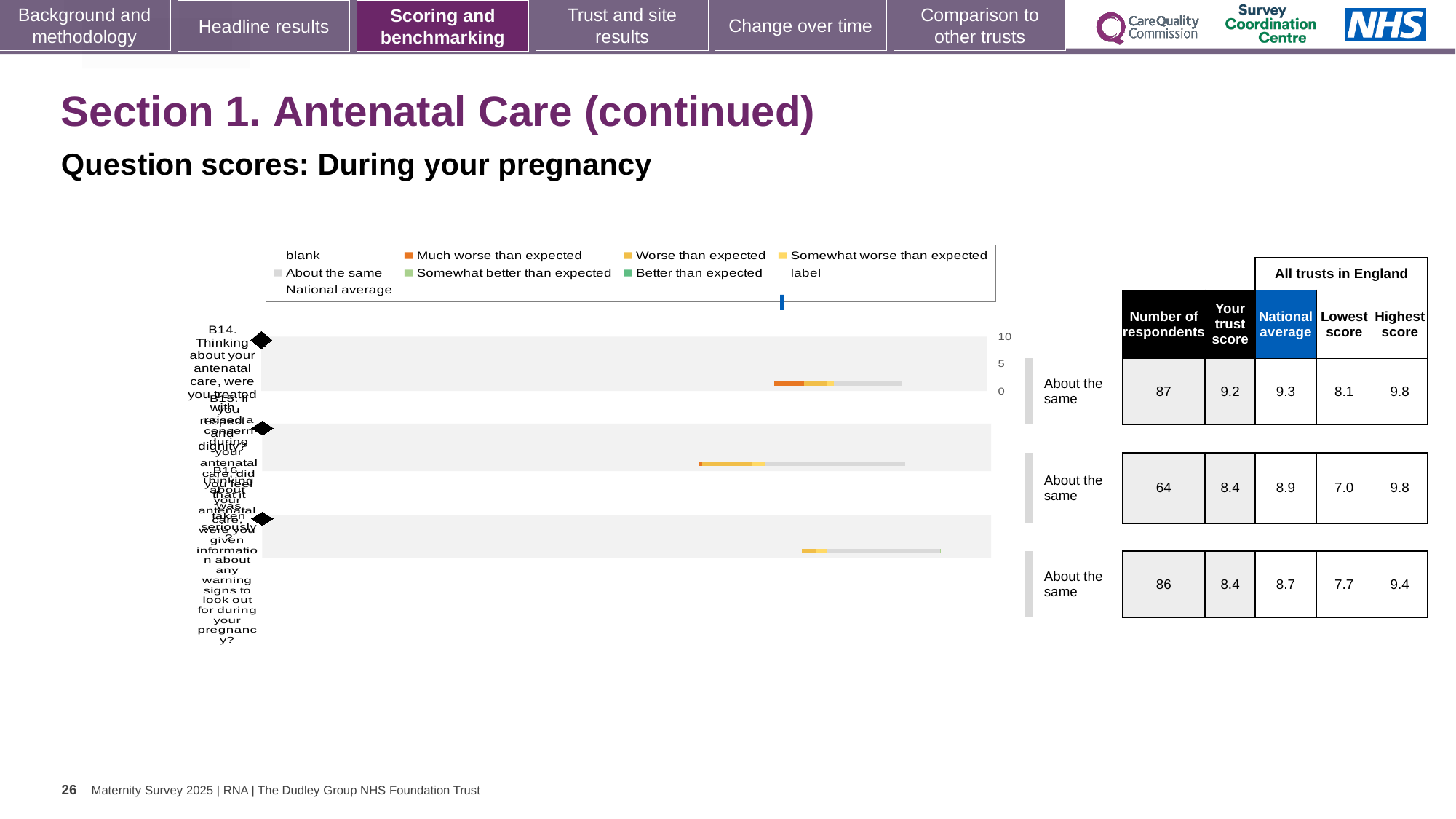
Which question row has the fewest respondents? the second row (64) Which question row has the highest 'Your trust score'? B14 (first row) How many respondents answered question B14, the first row of the table? 87 What is the lowest score among all trusts in England for the second question row? 7.0 How many question rows (bars) are plotted in the chart? 3 What is the 'Your trust score' for question B14 (treated with respect and dignity), the first row? 9.2 What is the national average for question B14, the first row of the table? 9.3 What benchmark category is shown for all three question rows? About the same What is the difference between the national average and the trust score for the second question row? 0.5 How many entries does the chart legend list? 9 What kind of chart is shown on the slide? bar chart What is the highest score among all trusts in England for the third question row? 9.4